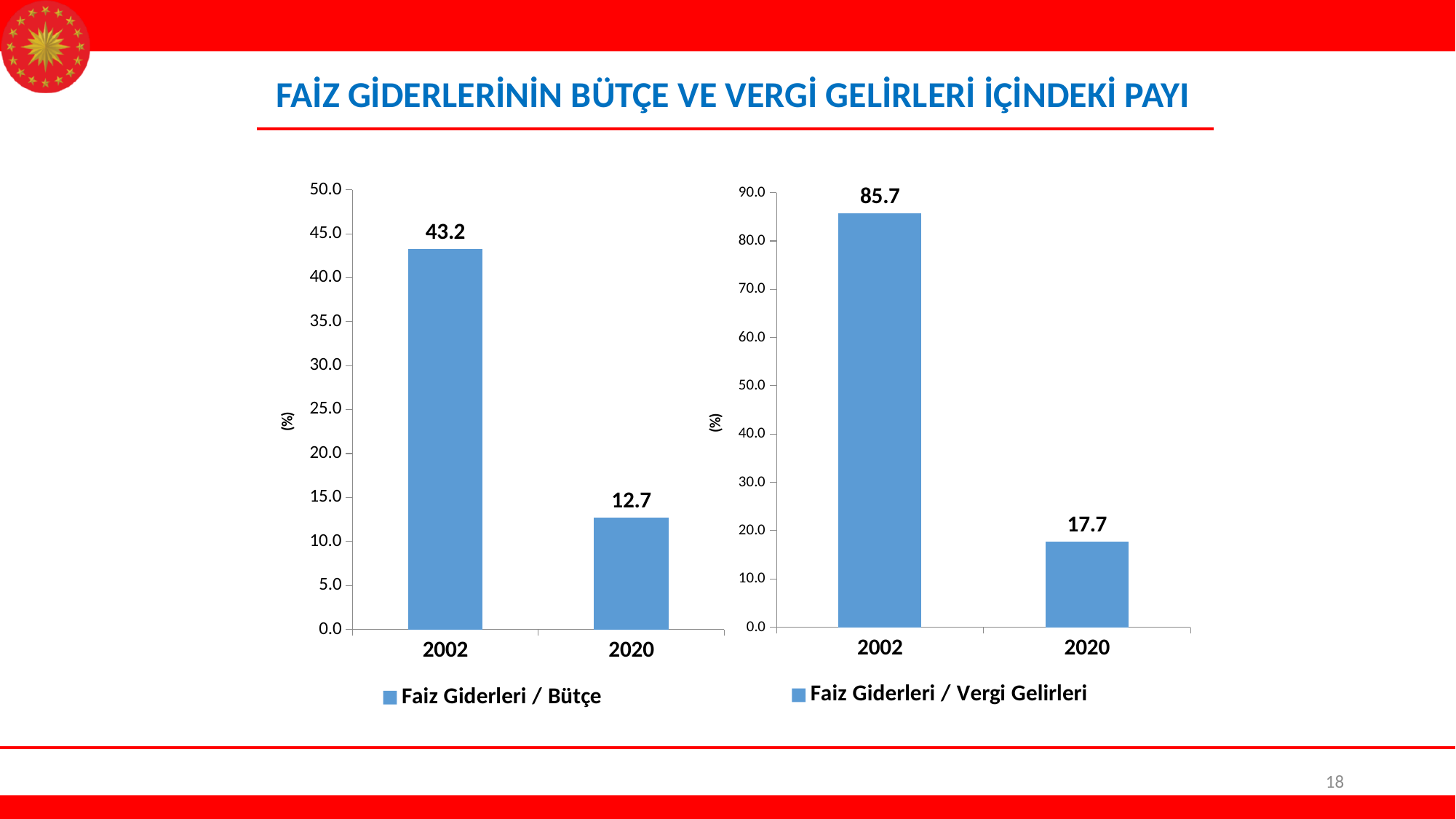
How many categories are shown on the x axis of the left chart (Faiz Giderleri / Bütçe)? 2 In the right chart (Faiz Giderleri / Vergi Gelirleri), what is the difference between the 2002 and 2020 values? 68.0 In the left chart (Faiz Giderleri / Bütçe), what is the value for 2020? 12.7 What kind of chart is the right chart (Faiz Giderleri / Vergi Gelirleri)? bar chart In the right chart (Faiz Giderleri / Vergi Gelirleri), which year has the lower value? 2020 In the left chart (Faiz Giderleri / Bütçe), what is the value for 2002? 43.2 In the left chart (Faiz Giderleri / Bütçe), which year has the higher value? 2002 In the right chart (Faiz Giderleri / Vergi Gelirleri), what is the value for 2002? 85.7 In the left chart (Faiz Giderleri / Bütçe), do the values rise or fall from 2002 to 2020? fall In the left chart (Faiz Giderleri / Bütçe), what is the difference between the 2002 and 2020 values? 30.5 In the right chart (Faiz Giderleri / Vergi Gelirleri), what is the value for 2020? 17.7 In the right chart (Faiz Giderleri / Vergi Gelirleri), is the value for 2020 greater or less than 20.0? less